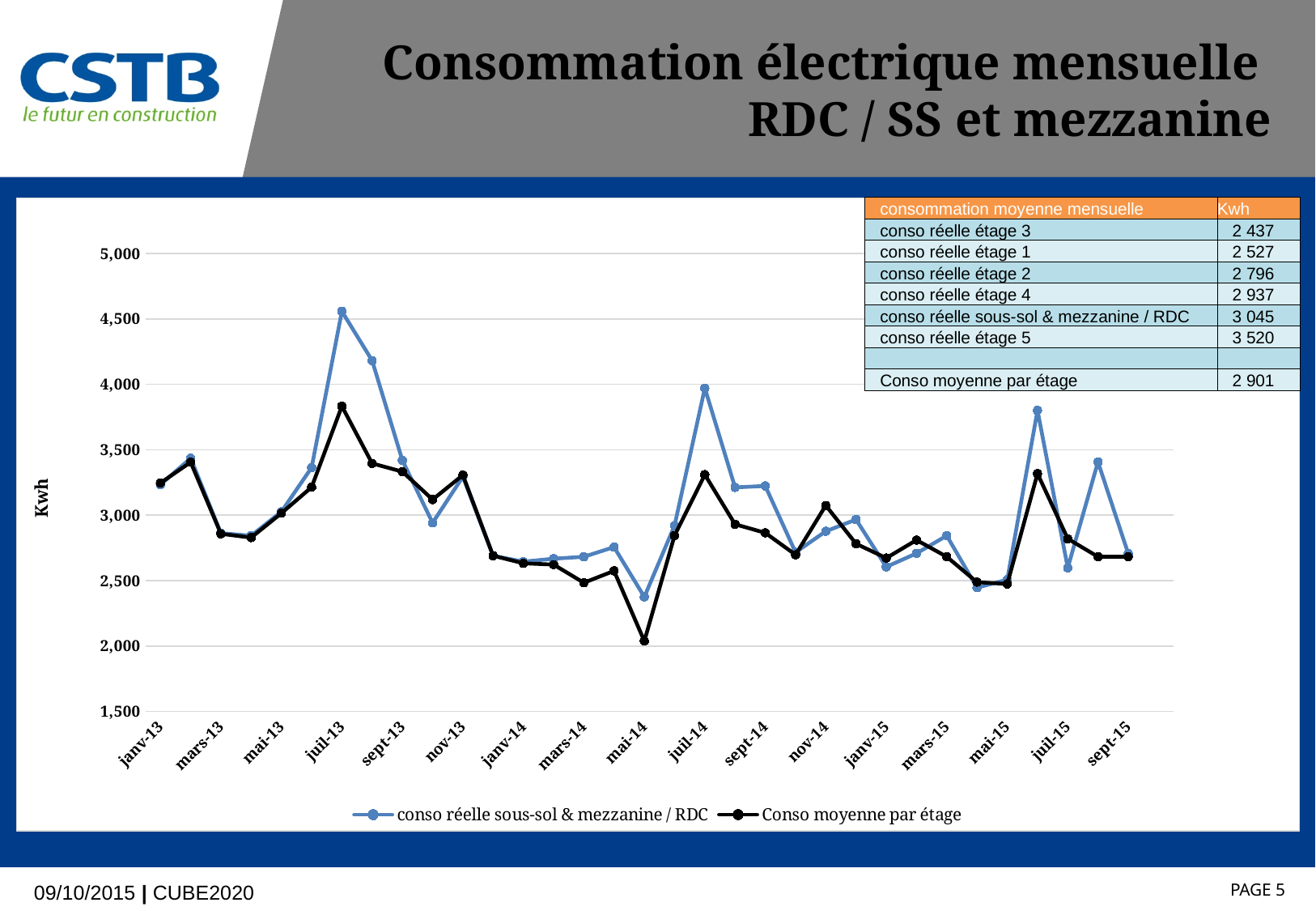
Is the value for 'Conso moyenne par étage' in mai-14 greater or less than 2,500? less How many series does the chart legend list? 2 In juil-13, which series has the larger value: 'conso réelle sous-sol & mezzanine / RDC' or 'Conso moyenne par étage'? conso réelle sous-sol & mezzanine / RDC Does the 'conso réelle sous-sol & mezzanine / RDC' series rise or fall between juil-13 and sept-13? fall In which month does the 'Conso moyenne par étage' series reach its lowest value? mai-14 Is the value for 'conso réelle sous-sol & mezzanine / RDC' in juil-14 greater or less than 3,500? greater What is the label on the vertical axis of the chart? Kwh Is the value for 'conso réelle sous-sol & mezzanine / RDC' in juil-13 greater or less than 4,000? greater In which month does the 'conso réelle sous-sol & mezzanine / RDC' series reach its highest value? juil-13 What kind of chart is shown on the slide? line chart